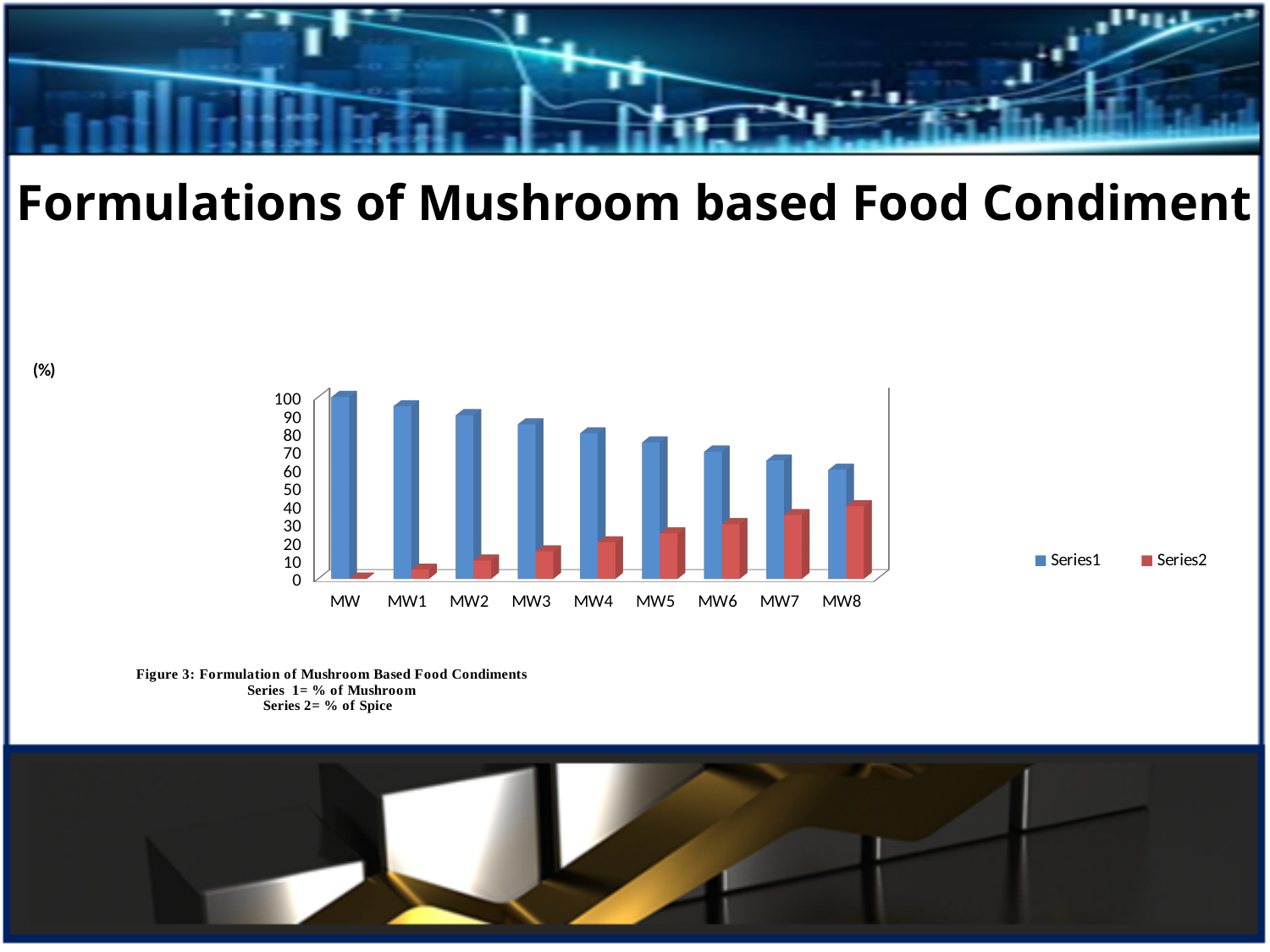
At MW4, which is larger, Series1 or Series2? Series1 How many series does the chart's legend list? 2 What kind of chart is shown on the slide? bar chart According to the caption, what does Series2 represent? % of Spice Which category has the highest Series2 value? MW8 Which category has the lowest Series1 value? MW8 Which category has the highest Series1 value? MW Is the Series2 value for MW8 greater or less than 30? greater Is the Series1 value for MW8 greater or less than 70? less How many categories are shown on the x axis of the chart? 9 Do the Series1 values rise or fall from MW to MW8? fall Do the Series2 values rise or fall from MW to MW8? rise